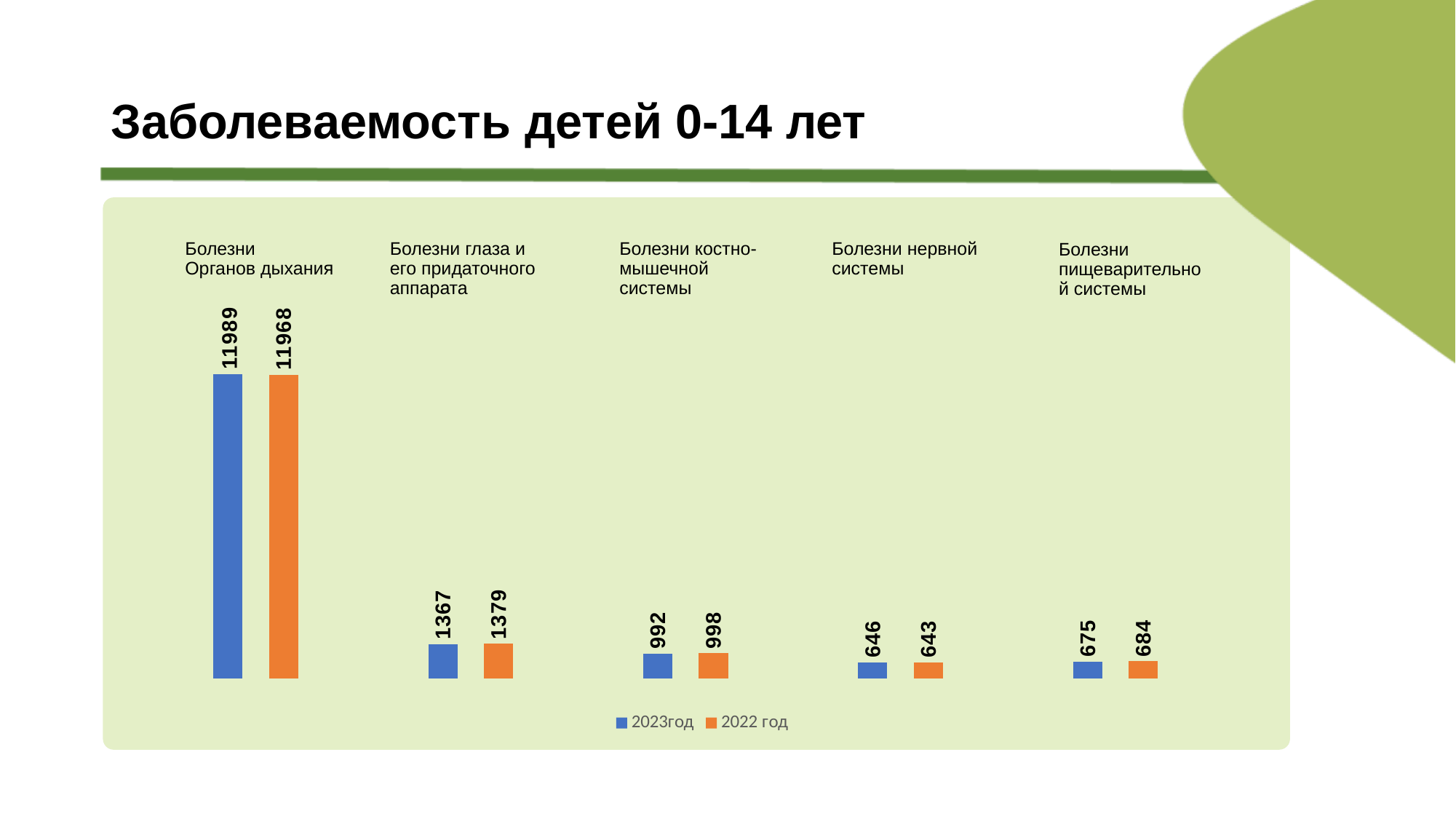
What is the value for Болезни глаза и его придаточного аппарата in 2022 год? 1379 How many disease categories are shown in the chart? 5 What is the value for Болезни органов дыхания in 2023год? 11989 Which series is shown in orange in the legend? 2022 год How many series does the legend list? 2 What is the value for Болезни нервной системы in 2023год? 646 What type of chart is shown on the slide? bar chart Which category has the highest value in 2023год? Болезни органов дыхания What is the value for Болезни пищеварительной системы in 2022 год? 684 Which category has the lowest value in 2022 год? Болезни нервной системы What is the value for Болезни органов дыхания in 2022 год? 11968 What is the difference between the 2023год and 2022 год values for Болезни органов дыхания? 21